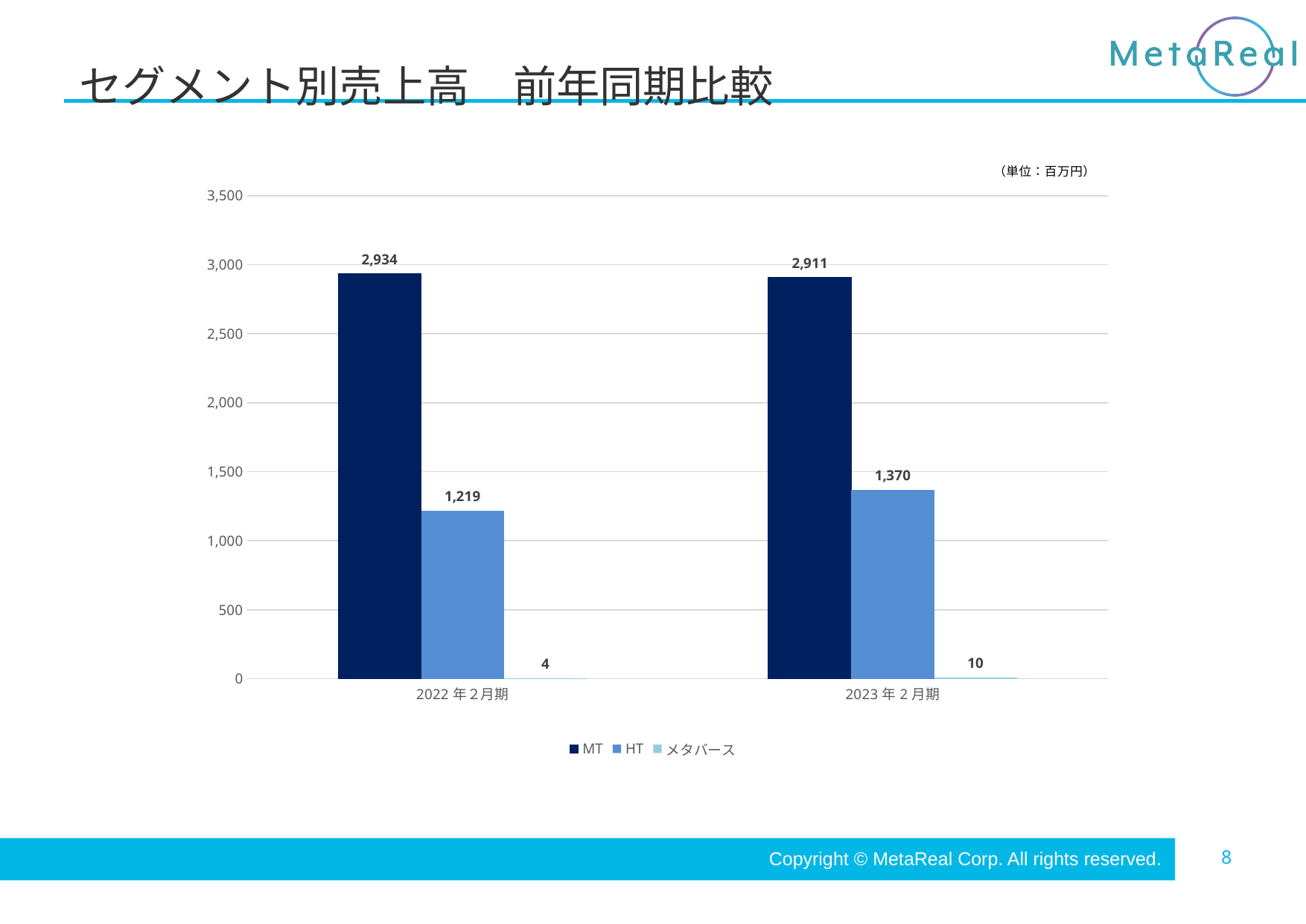
What kind of chart is shown on the slide? Bar chart Which is larger, the MT value for 2022年2月期 or the MT value for 2023年2月期? 2022年2月期 What is the difference between the HT values for 2023年2月期 and 2022年2月期? 151 How many categories are shown on the x axis? 2 What unit is indicated for the chart values? 百万円 Which series has the highest value in 2023年2月期? MT How many series does the legend list? 3 What is the メタバース value for 2023年2月期? 10 What is the HT value for 2023年2月期? 1,370 What is the MT value for 2022年2月期? 2,934 Which series has the lowest value in 2022年2月期? メタバース What is the メタバース value for 2022年2月期? 4